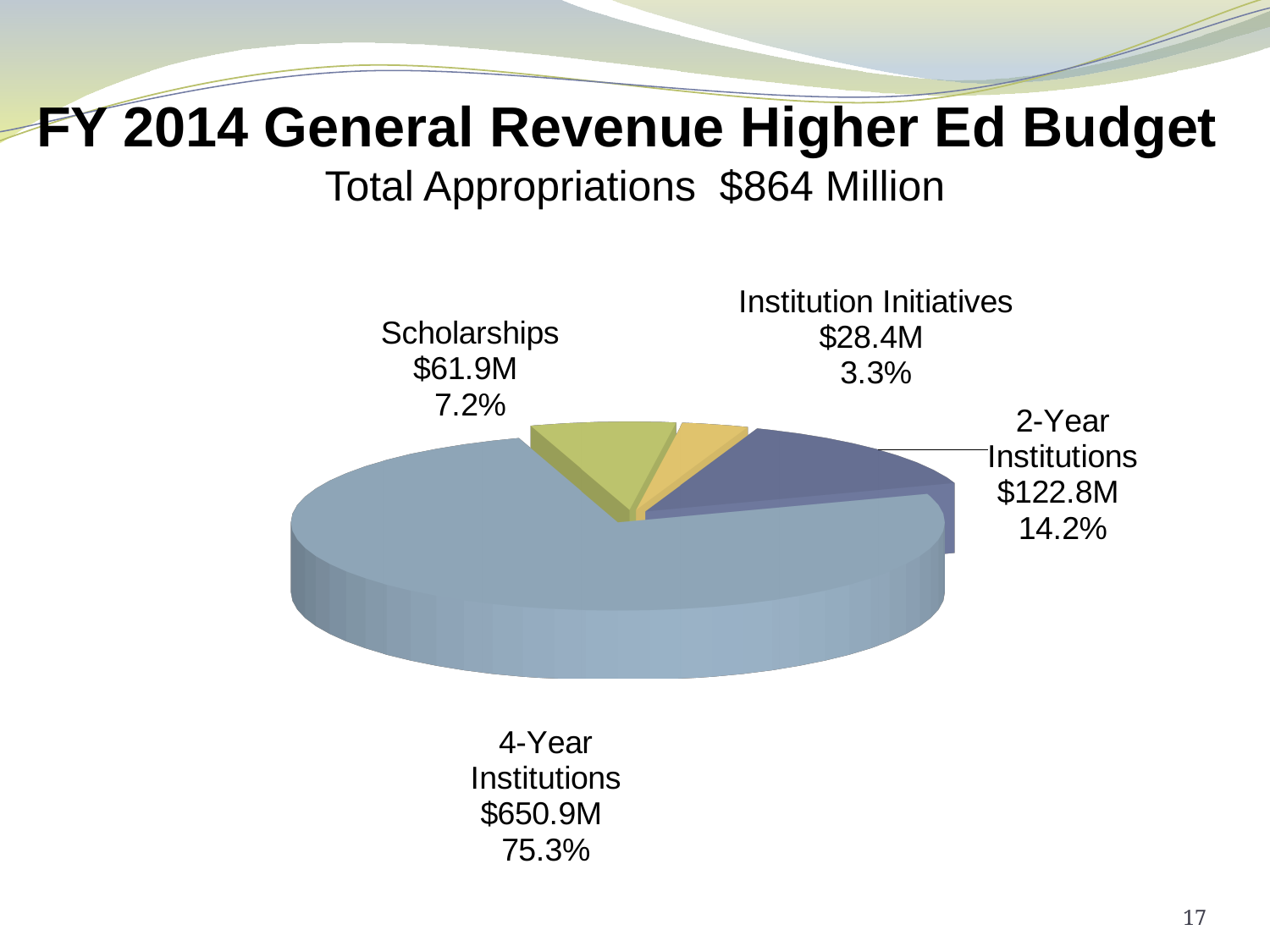
Which is larger, the amount for Scholarships or the amount for 2-Year Institutions? 2-Year Institutions How many slices does the pie chart have? 4 What is the difference in dollars between 2-Year Institutions and Scholarships? $60.9M What percentage of the budget goes to Institution Initiatives? 3.3% What total appropriations amount is stated in the chart's subtitle? $864 Million What kind of chart is shown on the slide? Pie chart Which category has the largest slice of the pie? 4-Year Institutions What is the dollar amount for 4-Year Institutions? $650.9M What share of the pie do 2-Year Institutions represent? 14.2% What is the dollar amount for Scholarships? $61.9M Which category has the smallest slice of the pie? Institution Initiatives What is the difference in percentage points between 4-Year Institutions and 2-Year Institutions? 61.1 percentage points